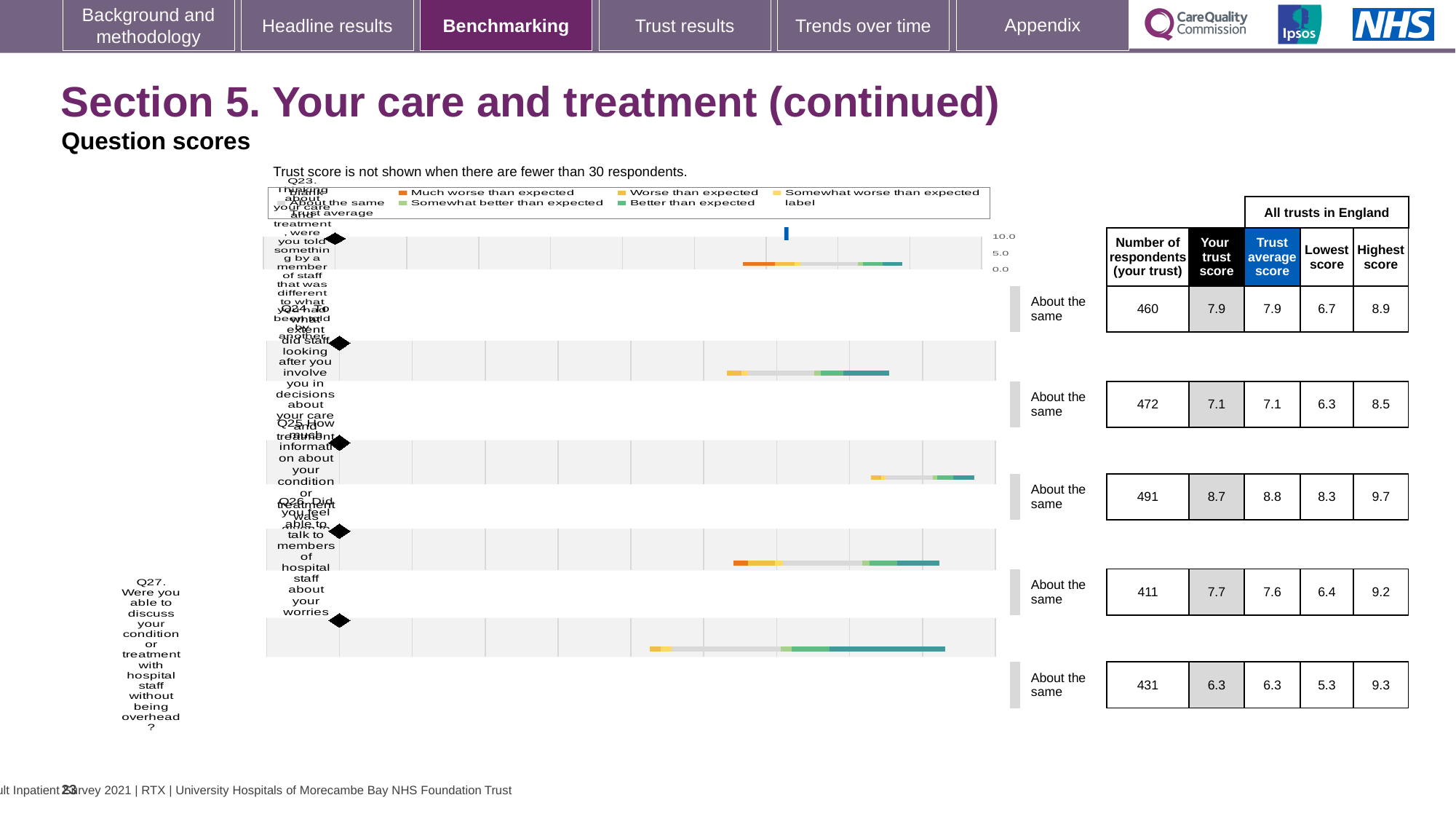
According to the note above the chart, when is the trust score not shown? When there are fewer than 30 respondents What is the 'Your trust score' for Q24 (to what extent did staff involve you in decisions about your care and treatment)? 7.1 What kind of chart is used to show the question scores for Q23 to Q27? bar chart Which question has the highest 'Your trust score'? Q25 Which question has the lowest 'Your trust score'? Q27 How many respondents (your trust) are shown for Q25? 491 What is the difference between the highest score and the lowest score across all trusts in England for Q25? 1.4 What is the lowest score across all trusts in England for Q27? 5.3 What is the highest score across all trusts in England for Q23? 8.9 For Q26, which is larger: 'Your trust score' or 'Trust average score'? Your trust score How many questions (Q23 to Q27) are plotted in the chart? 5 Is the 'Your trust score' for Q27 greater or less than 5.0? greater